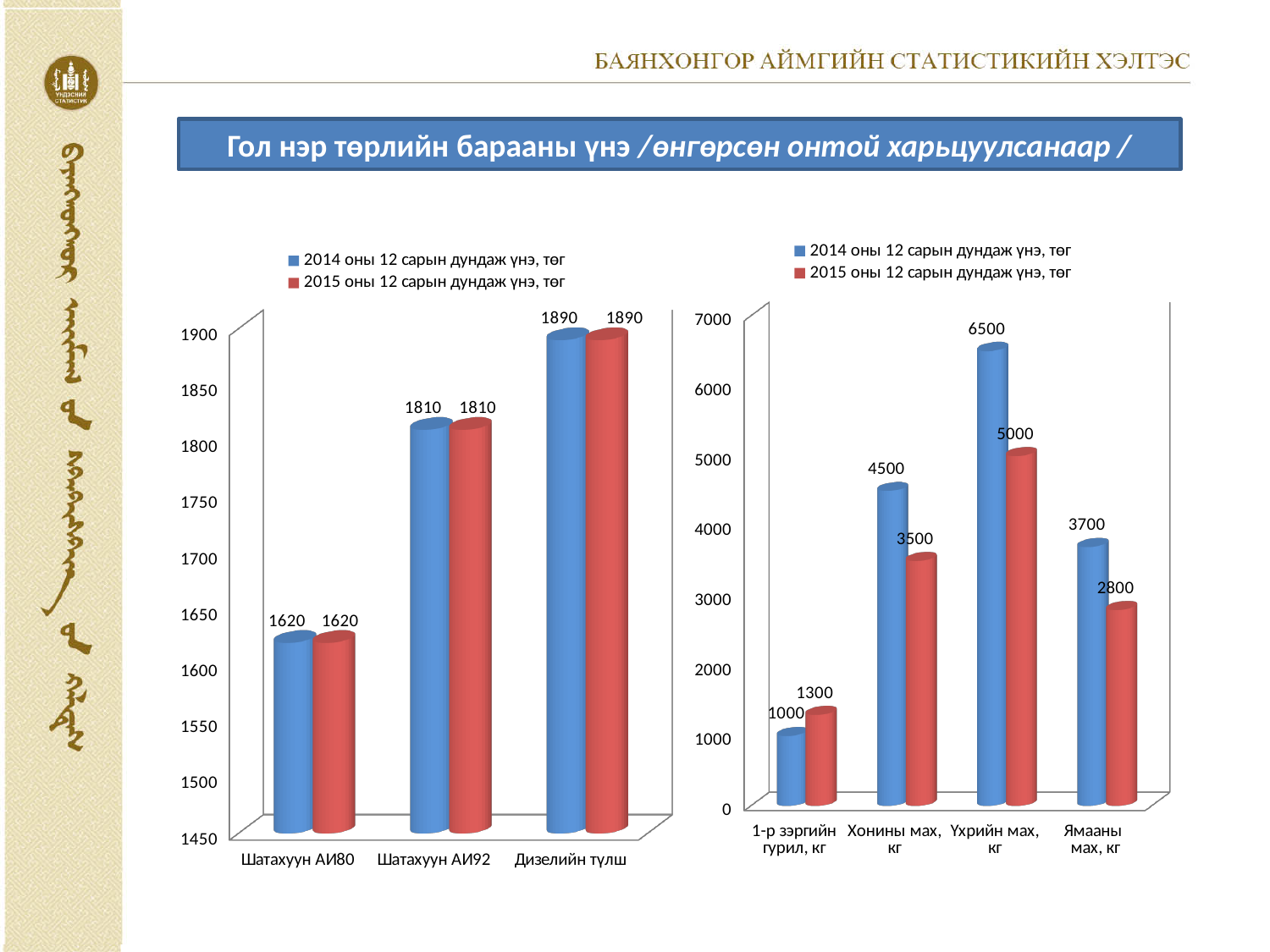
In the right chart, what is the 2014 оны 12 сарын дундаж үнэ for 1-р зэргийн гурил, кг? 1000 What kind of chart is the left chart? Bar chart In the right chart, what is the 2015 оны 12 сарын дундаж үнэ for Үхрийн мах, кг? 5000 How many categories are shown on the x axis of the left chart? 3 In the left chart, what is the 2014 оны 12 сарын дундаж үнэ for Шатахуун АИ92? 1810 How many series does the legend of the right chart list? 2 In the right chart, which is larger for 1-р зэргийн гурил, кг: the 2014 value or the 2015 value? 2015 value In the right chart, what is the difference between the 2014 and 2015 values for Ямааны мах, кг? 900 In the right chart, which category has the highest 2014 оны 12 сарын дундаж үнэ? Үхрийн мах, кг In the right chart, what is the difference between the 2014 and 2015 values for Хонины мах, кг? 1000 In the left chart, do the 2014 values rise or fall from Шатахуун АИ80 to Дизелийн түлш? Rise In the left chart, which category has the lowest 2015 оны 12 сарын дундаж үнэ? Шатахуун АИ80